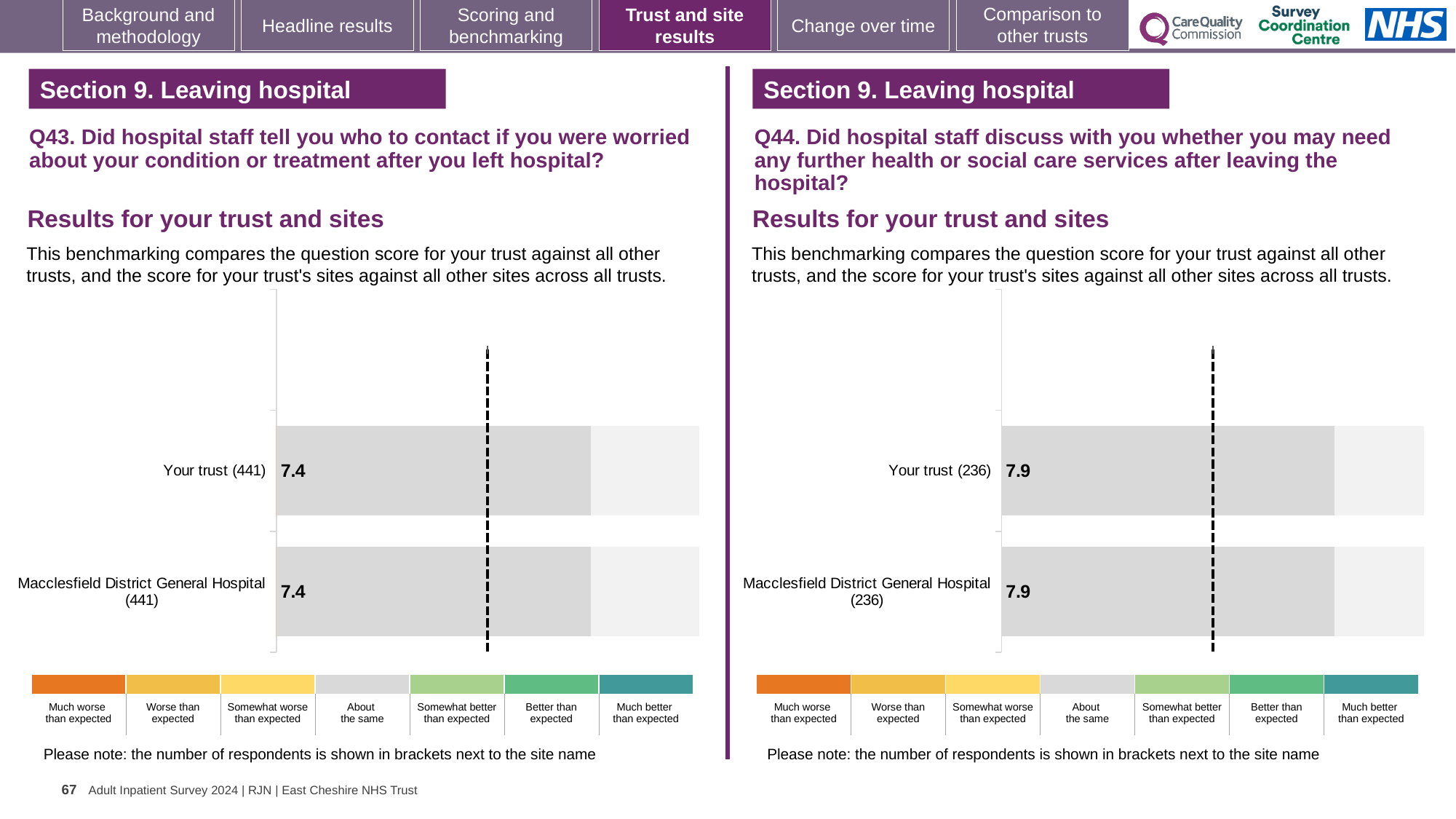
In the Q44 chart on the right, what is the score for Macclesfield District General Hospital? 7.9 In the Q43 chart on the left, what is the difference between the score for Your trust and the score for Macclesfield District General Hospital? 0 In the Q43 chart on the left, what is the score for Your trust? 7.4 What is the difference between the Your trust score in the Q44 chart on the right and the Your trust score in the Q43 chart on the left? 0.5 In the Q43 chart on the left, how many respondents are shown in brackets next to Your trust? 441 In the Q43 chart on the left, how many bars are plotted? 2 In the Q44 chart on the right, what is the score for Your trust? 7.9 How many categories does the colour key below the Q44 chart on the right list? 7 What kind of chart is the Q43 chart on the left? Bar chart Is the score for Your trust in the Q43 chart on the left larger or smaller than the score for Your trust in the Q44 chart on the right? Smaller In the Q44 chart on the right, how many bars are plotted? 2 In the Q43 chart on the left, what is the score for Macclesfield District General Hospital? 7.4